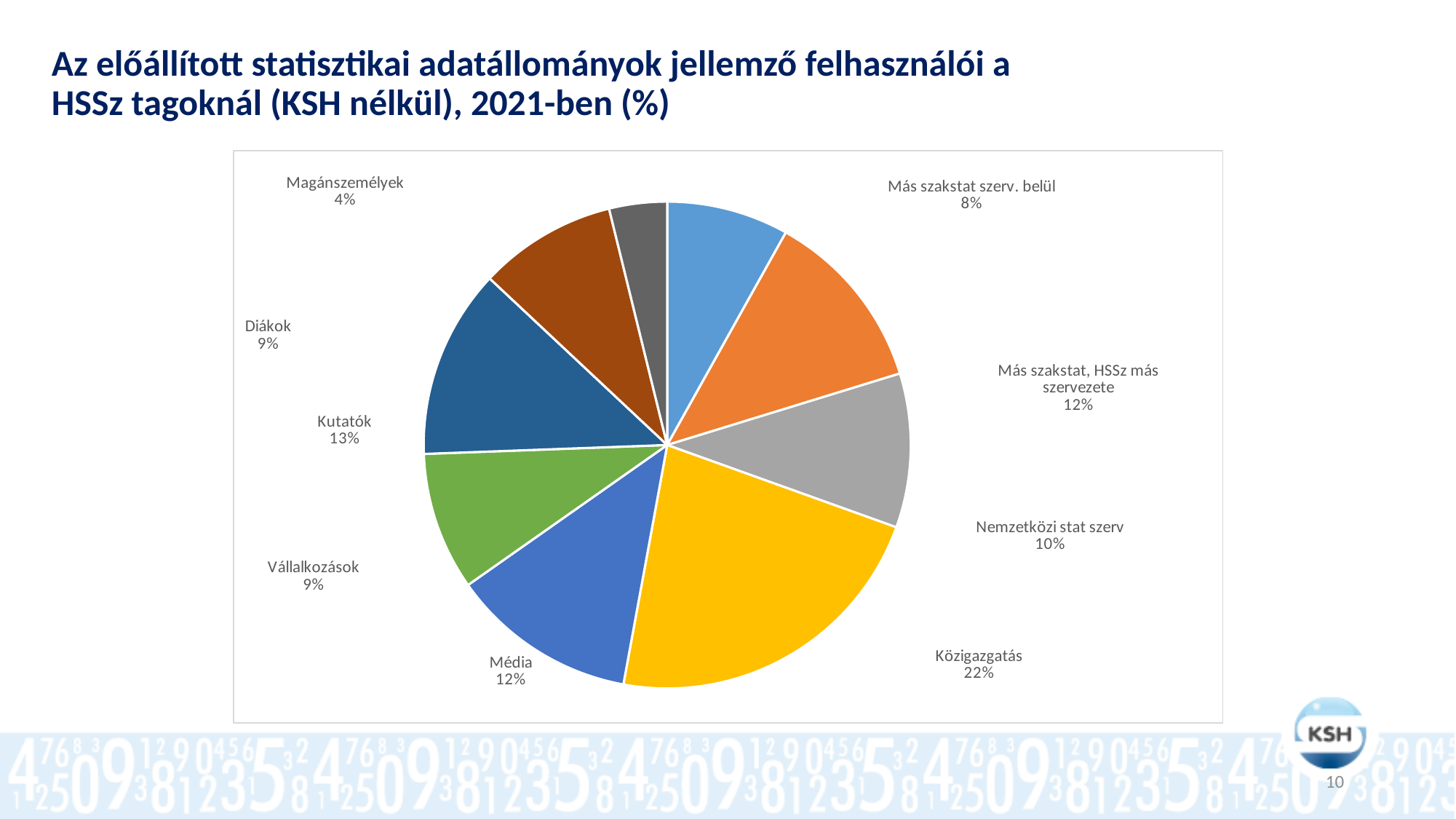
What is the value for Kutatók? 13% What is the value for Nemzetközi stat szerv? 10% How many slices does the pie chart have? 9 What is the difference between the shares of Közigazgatás and Kutatók? 9 percentage points What kind of chart is shown on the slide? pie chart What share of the pie does Közigazgatás have? 22% What is the value for Magánszemélyek? 4% What colour is the Közigazgatás slice? yellow Which category has the largest slice of the pie? Közigazgatás What is the difference between the shares of Más szakstat, HSSz más szervezete and Más szakstat szerv. belül? 4 percentage points Which is larger, the share for Média or the share for Vállalkozások? Média Which category has the smallest slice of the pie? Magánszemélyek